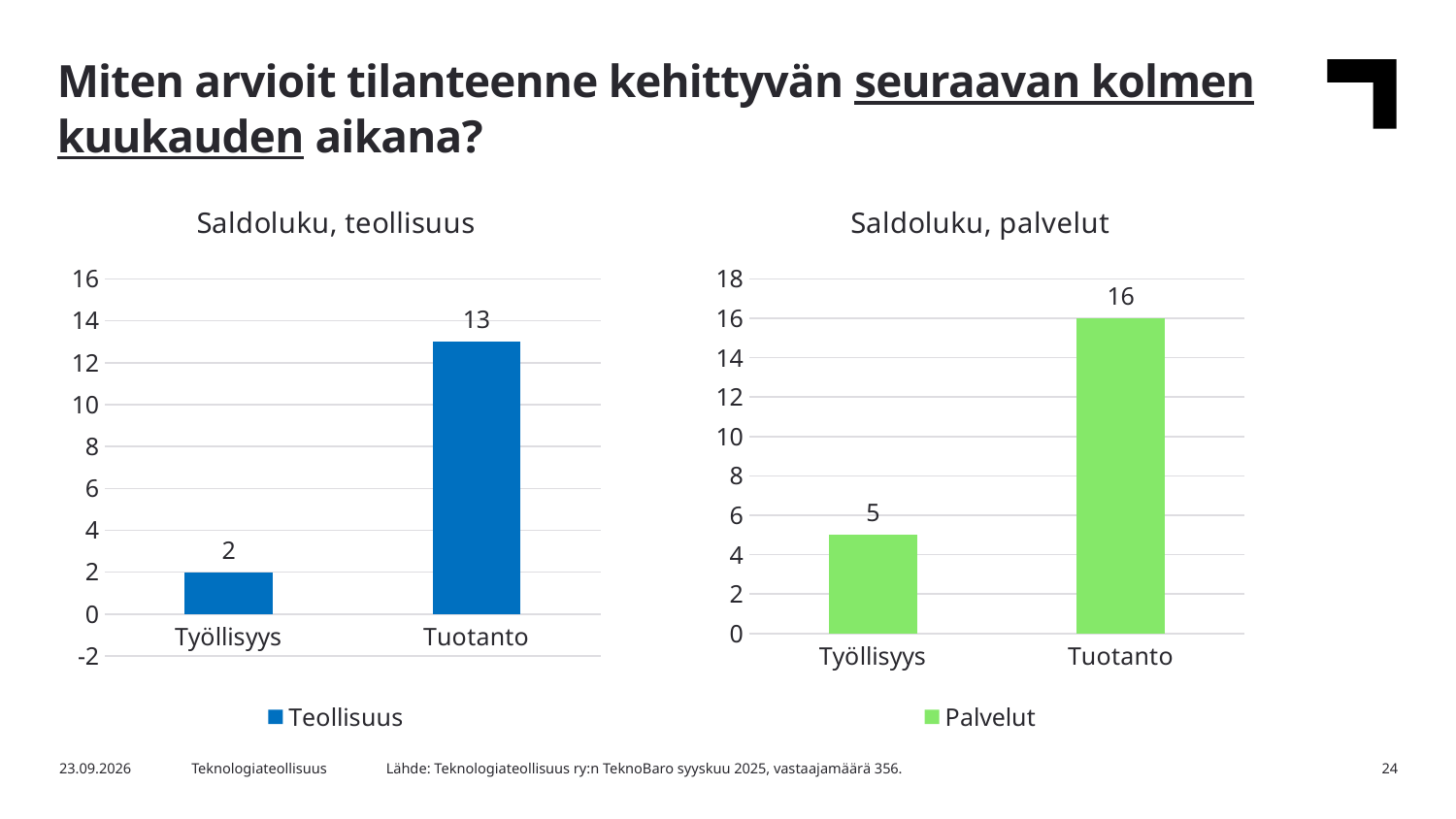
In the 'Saldoluku, teollisuus' chart, what is the difference between the values for Tuotanto and Työllisyys? 11 In the 'Saldoluku, teollisuus' chart, what is the value for Tuotanto? 13 In the 'Saldoluku, teollisuus' chart, what is the value for Työllisyys? 2 In the 'Saldoluku, palvelut' chart, what is the value for Työllisyys? 5 In the 'Saldoluku, palvelut' chart, what is the difference between the values for Tuotanto and Työllisyys? 11 How many categories are shown in the 'Saldoluku, palvelut' chart? 2 Which is larger: the Tuotanto value in the 'Saldoluku, teollisuus' chart or the Tuotanto value in the 'Saldoluku, palvelut' chart? Saldoluku, palvelut What series name does the legend of the 'Saldoluku, palvelut' chart show? Palvelut In the 'Saldoluku, palvelut' chart, what is the value for Tuotanto? 16 In the 'Saldoluku, palvelut' chart, which category has the lowest value? Työllisyys What kind of chart is the 'Saldoluku, teollisuus' chart? Bar chart In the 'Saldoluku, teollisuus' chart, which category has the highest value? Tuotanto